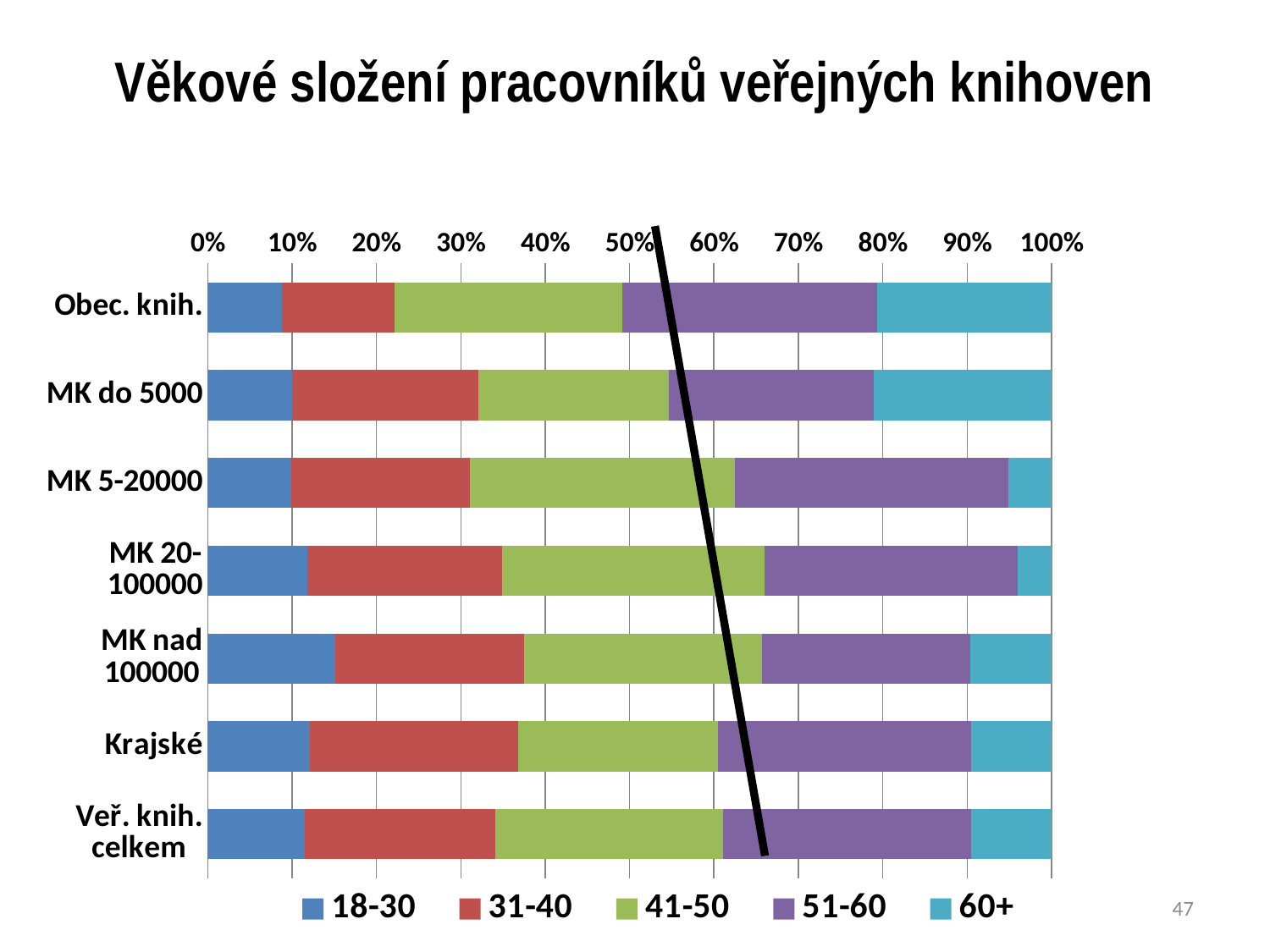
Is the 60+ share for Obec. knih. greater or less than 10%? greater Is the 41-50 share for Obec. knih. greater or less than 30%? less How many age-group series does the legend list? 5 What kind of chart is shown on the slide? Stacked bar chart Which category has the largest 18-30 share? MK nad 100000 Which has the larger 18-30 share, MK nad 100000 or Obec. knih.? MK nad 100000 Is the 60+ share for MK 20-100000 greater or less than 10%? less Which has the larger 60+ share, Obec. knih. or MK 5-20000? Obec. knih. Which age group is shown in blue (the first legend entry)? 18-30 What is the title of the chart? Věkové složení pracovníků veřejných knihoven How many library categories are plotted on the chart? 7